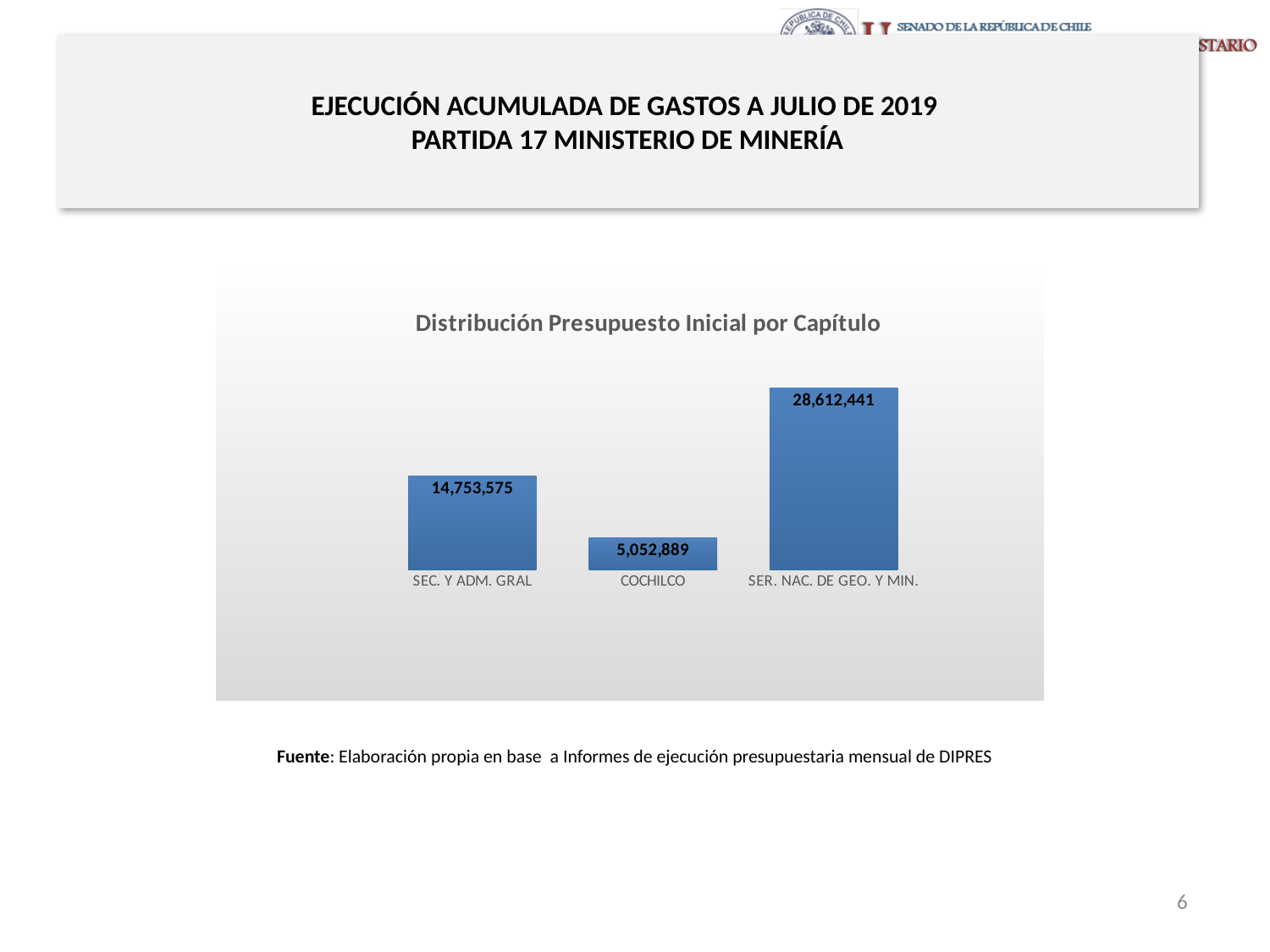
Which category has the lowest value? COCHILCO How many categories are shown in the chart? 3 Which is larger, the value for SEC. Y ADM. GRAL or the value for COCHILCO? SEC. Y ADM. GRAL What colour are the bars in the chart? Blue Which category has the highest value? SER. NAC. DE GEO. Y MIN. What is the value for SER. NAC. DE GEO. Y MIN.? 28,612,441 What kind of chart is shown on the slide? Bar chart What is the title of the chart? Distribución Presupuesto Inicial por Capítulo What is the difference between the values for SEC. Y ADM. GRAL and COCHILCO? 9,700,686 What is the value for COCHILCO? 5,052,889 What is the value for SEC. Y ADM. GRAL? 14,753,575 What is the difference between the values for SER. NAC. DE GEO. Y MIN. and SEC. Y ADM. GRAL? 13,858,866